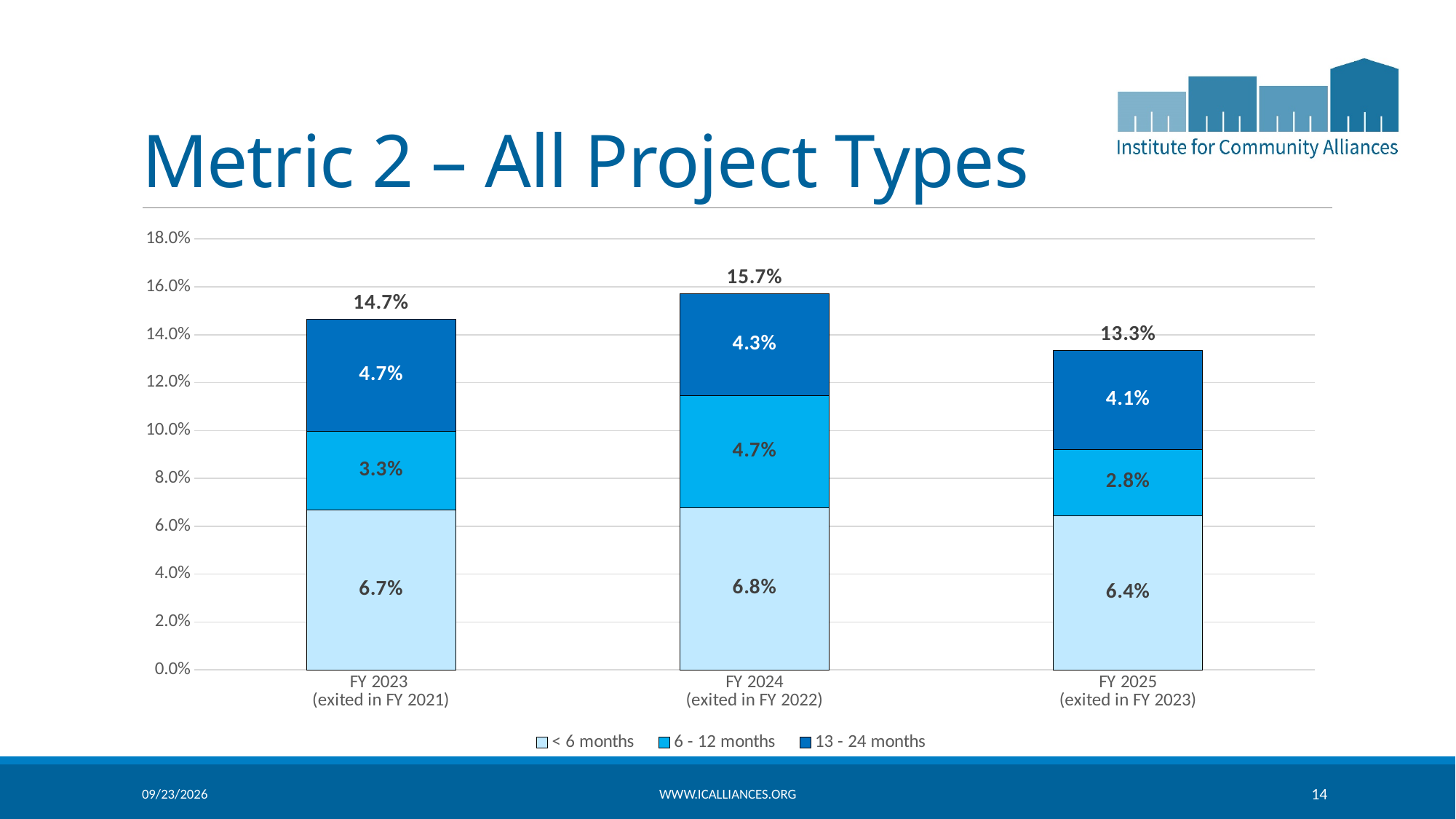
Which is larger: the '6 - 12 months' value in FY 2024 or in FY 2025? FY 2024 What is the value for '< 6 months' in FY 2024? 6.8% Which fiscal year has the highest stacked bar total? FY 2024 What kind of chart is shown on the slide? Stacked bar chart Does the '13 - 24 months' value rise or fall from FY 2023 to FY 2025? Fall What is the total of the stacked bar for FY 2024? 15.7% How many series does the legend list? 3 What is the difference between the FY 2024 total and the FY 2025 total? 2.4% What is the value for '6 - 12 months' in FY 2023? 3.3% Which fiscal year has the lowest stacked bar total? FY 2025 What is the value for '13 - 24 months' in FY 2025? 4.1% How many fiscal year categories are shown on the x axis? 3